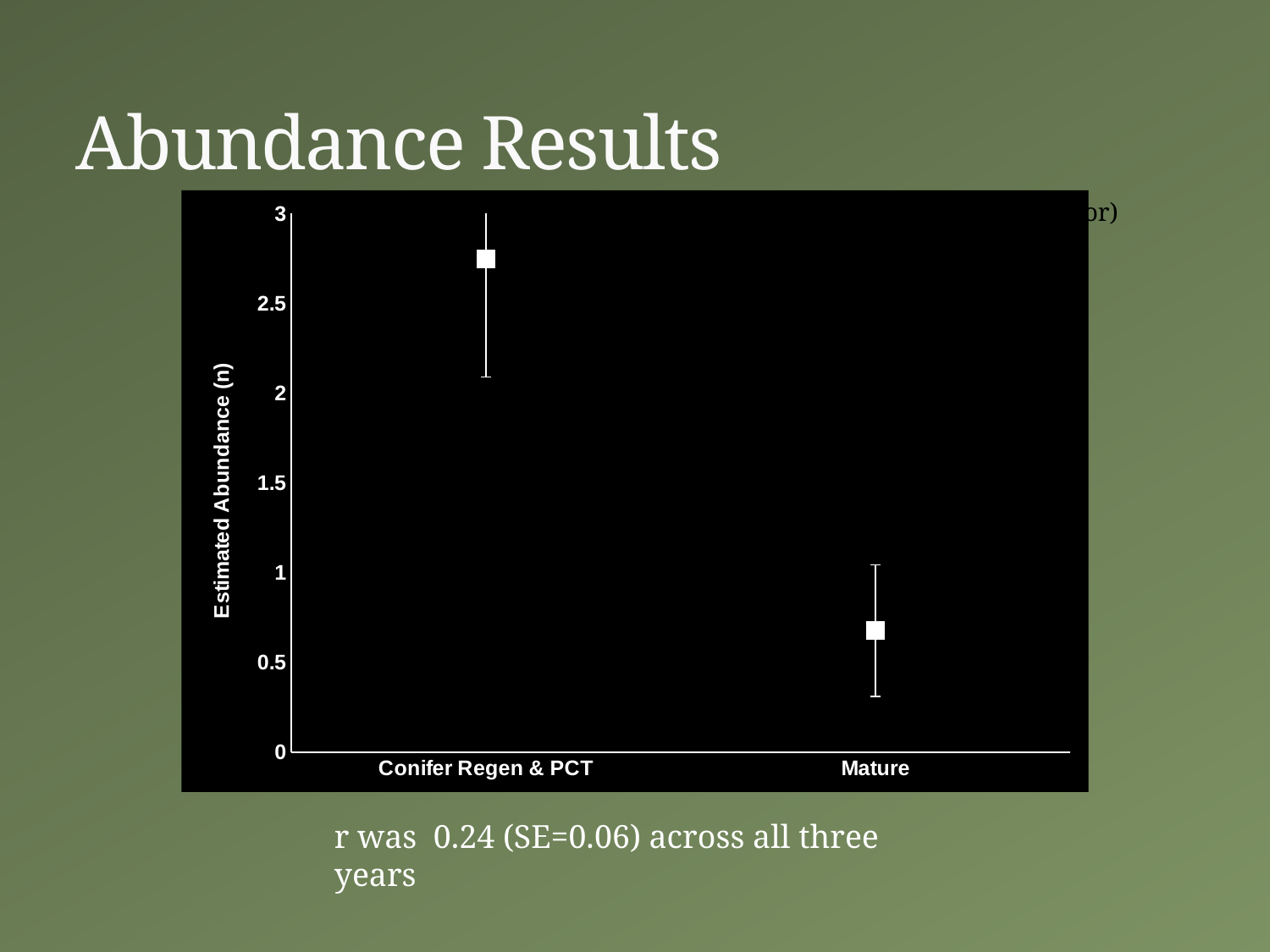
Is the estimated abundance for Conifer Regen & PCT larger or smaller than that for Mature? larger What is the highest value shown on the y axis? 3 How many categories are plotted on the x axis? 2 Is the estimated abundance for Conifer Regen & PCT greater or less than 2.5? greater Which category has the higher estimated abundance? Conifer Regen & PCT What is the label of the y axis? Estimated Abundance (n) Is the estimated abundance for Mature greater or less than 0.5? greater Is the estimated abundance for Conifer Regen & PCT greater or less than 3? less Do the plotted values rise or fall from Conifer Regen & PCT to Mature? fall Which category has the lower estimated abundance? Mature